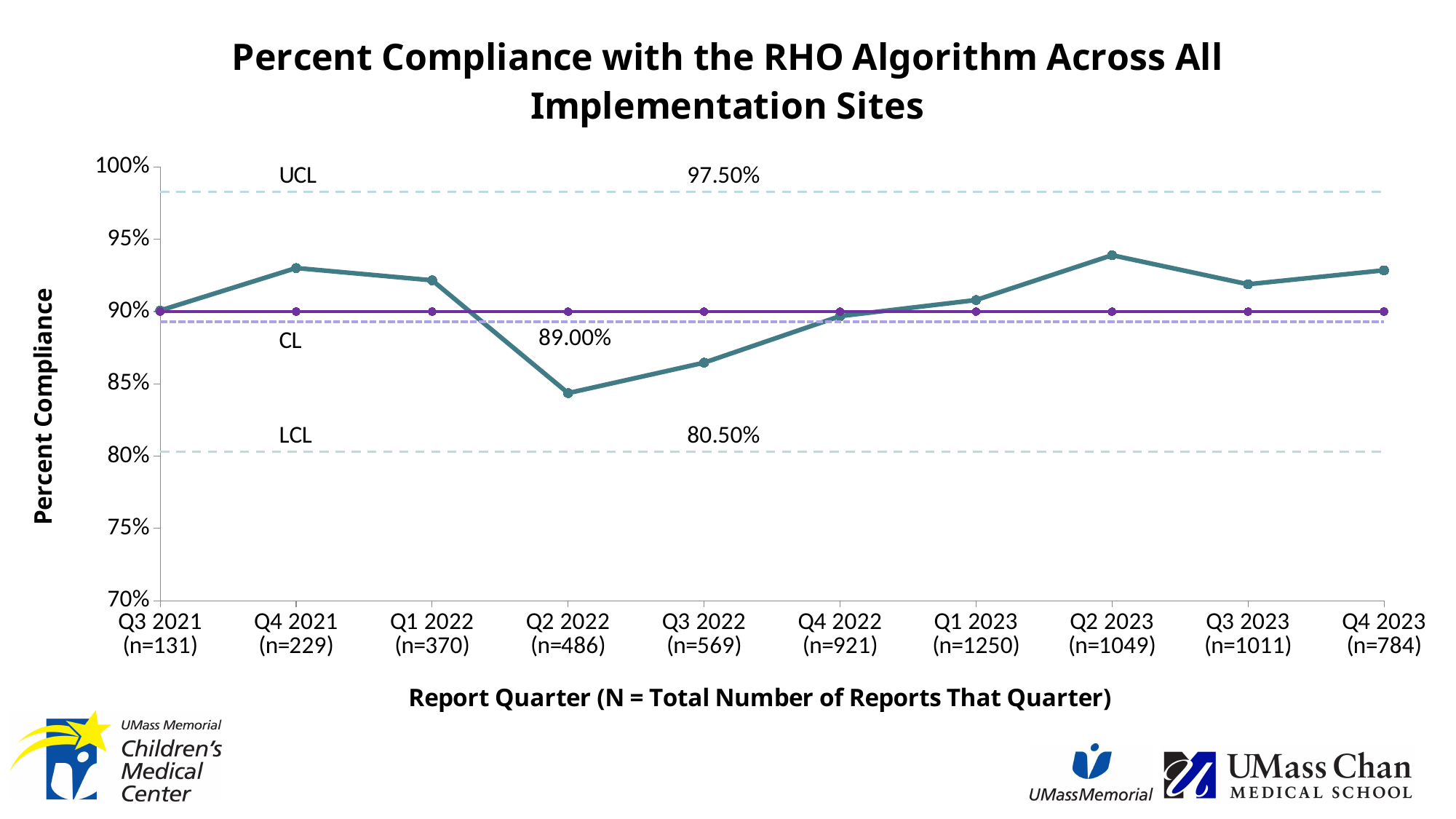
Is the percent compliance for Q3 2022 greater or less than 90%? less Is the percent compliance for Q2 2023 greater or less than 90%? greater What value is printed for the UCL (upper control limit)? 97.50% Which has the higher percent compliance, Q4 2021 or Q2 2022? Q4 2021 Which report quarter has the lowest percent compliance? Q2 2022 What value is printed for the CL (center line)? 89.00% What kind of chart is shown on the slide? line chart Is the percent compliance for Q2 2022 greater or less than 85%? less What value is printed for the LCL (lower control limit)? 80.50% Does percent compliance rise or fall from Q2 2022 to Q2 2023? rise How many report quarters are plotted along the x axis? 10 What is the total number of reports (N) shown for Q1 2023? n=1250